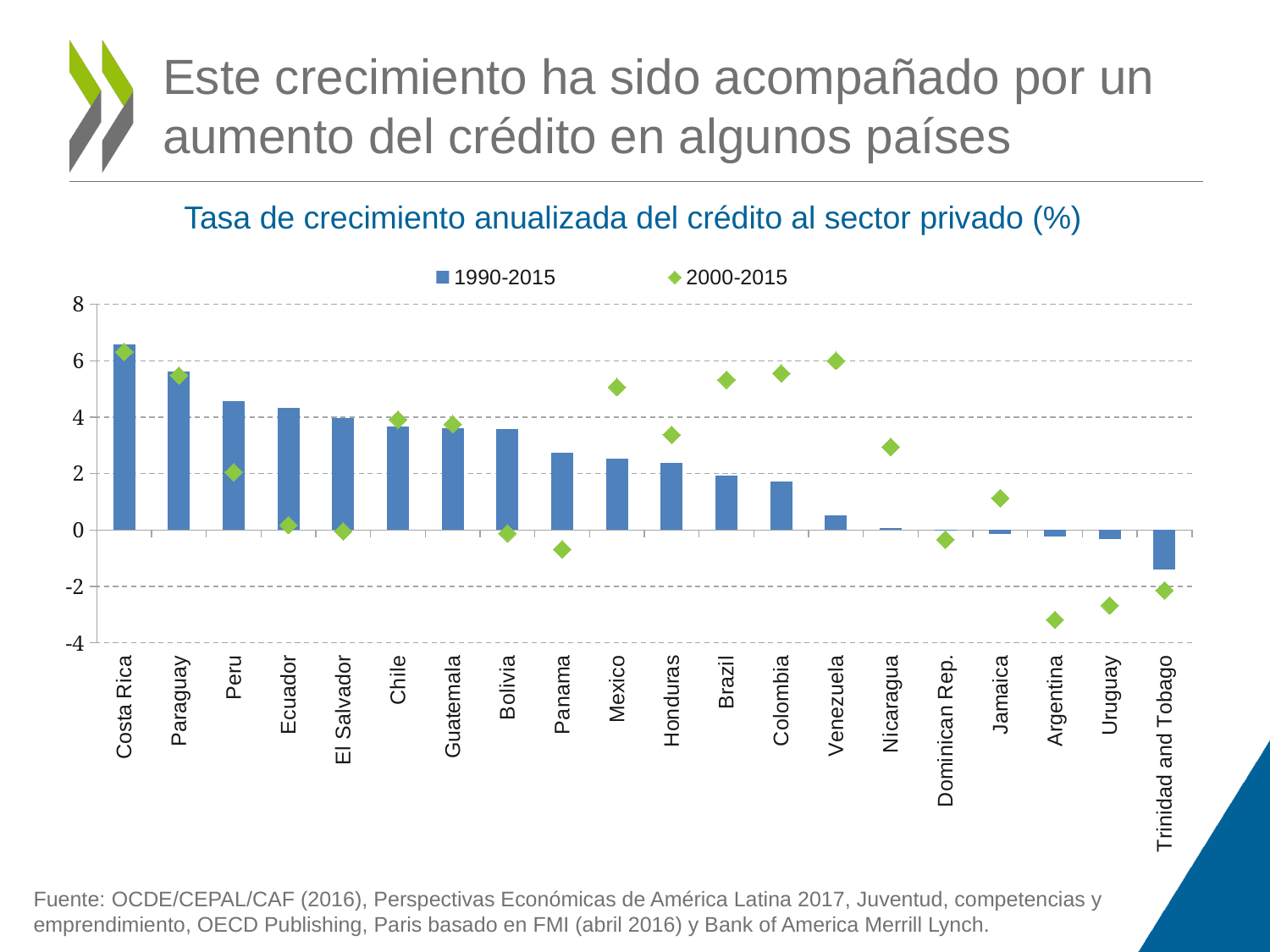
Which country has the lowest 2000-2015 marker? Argentina Is the 1990-2015 value for Costa Rica greater or less than 6? greater How many countries are shown on the x axis? 20 What is the title of the chart? Tasa de crecimiento anualizada del crédito al sector privado (%) Which country has the highest bar for 1990-2015? Costa Rica How many series does the legend list? 2 Which is larger for Peru: the 1990-2015 bar or the 2000-2015 marker? 1990-2015 bar Do the 1990-2015 bars rise or fall from left to right across the countries? fall Which country has the lowest bar for 1990-2015? Trinidad and Tobago Is the 2000-2015 value for Colombia greater or less than 4? greater What kind of chart is shown on the slide? bar chart (with diamond markers for the second series) Is the 2000-2015 value for Argentina greater or less than -2? less